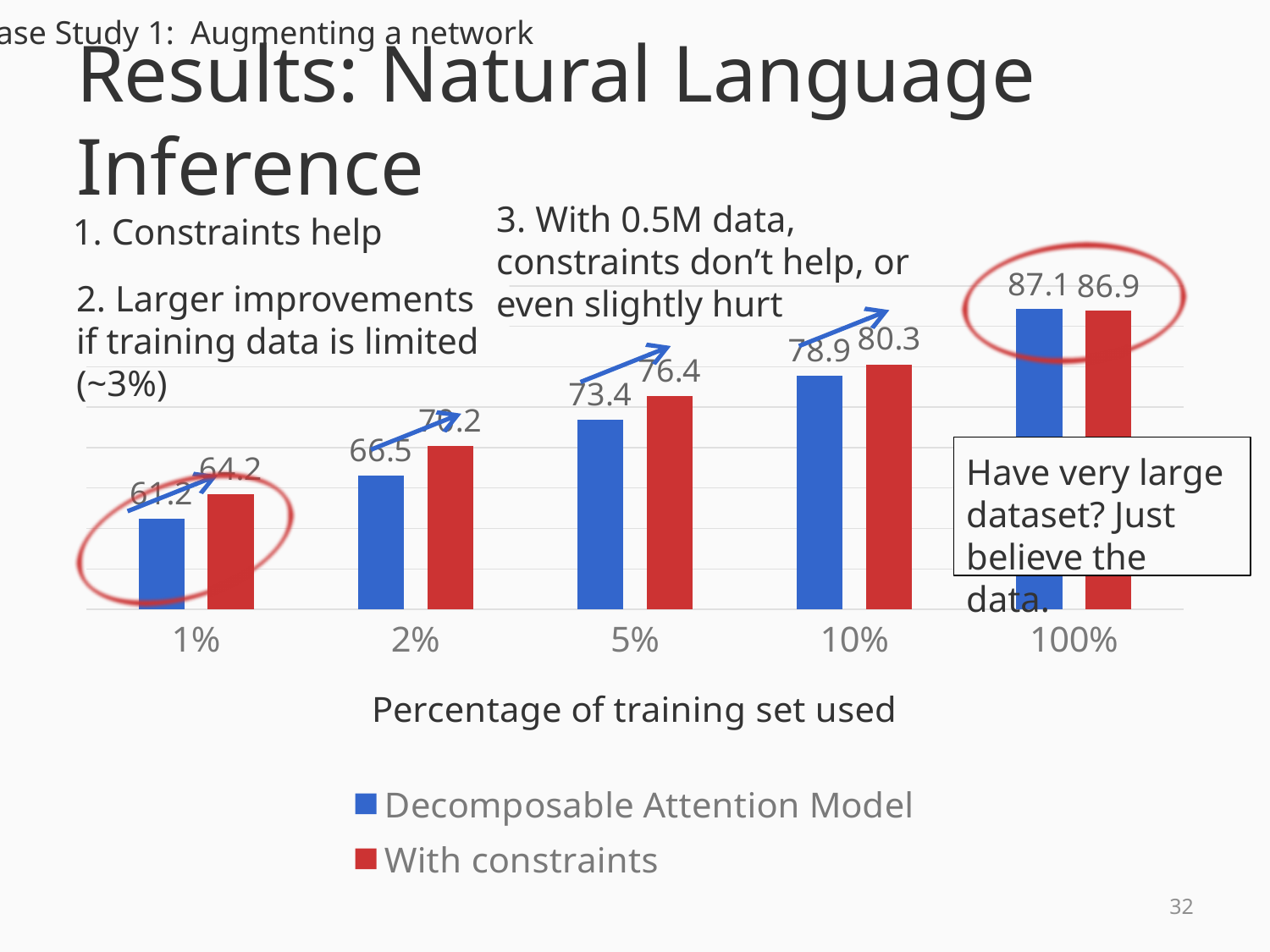
What is the value for the Decomposable Attention Model at 100% of the training set? 87.1 What is the value for the Decomposable Attention Model at 5% of the training set? 73.4 What is the value for With constraints at 10% of the training set? 80.3 How many series does the legend list? 2 At which percentage of the training set is the With constraints value lowest? 1% At which percentage of the training set is the Decomposable Attention Model value highest? 100% How many categories are shown on the x axis? 5 What is the value for the Decomposable Attention Model at 1% of the training set? 61.2 What kind of chart is shown on the slide? bar chart What is the difference between the With constraints and Decomposable Attention Model values at 5%? 3 What is the value for With constraints at 1% of the training set? 64.2 Do the Decomposable Attention Model values rise or fall as the percentage of training set used increases? rise